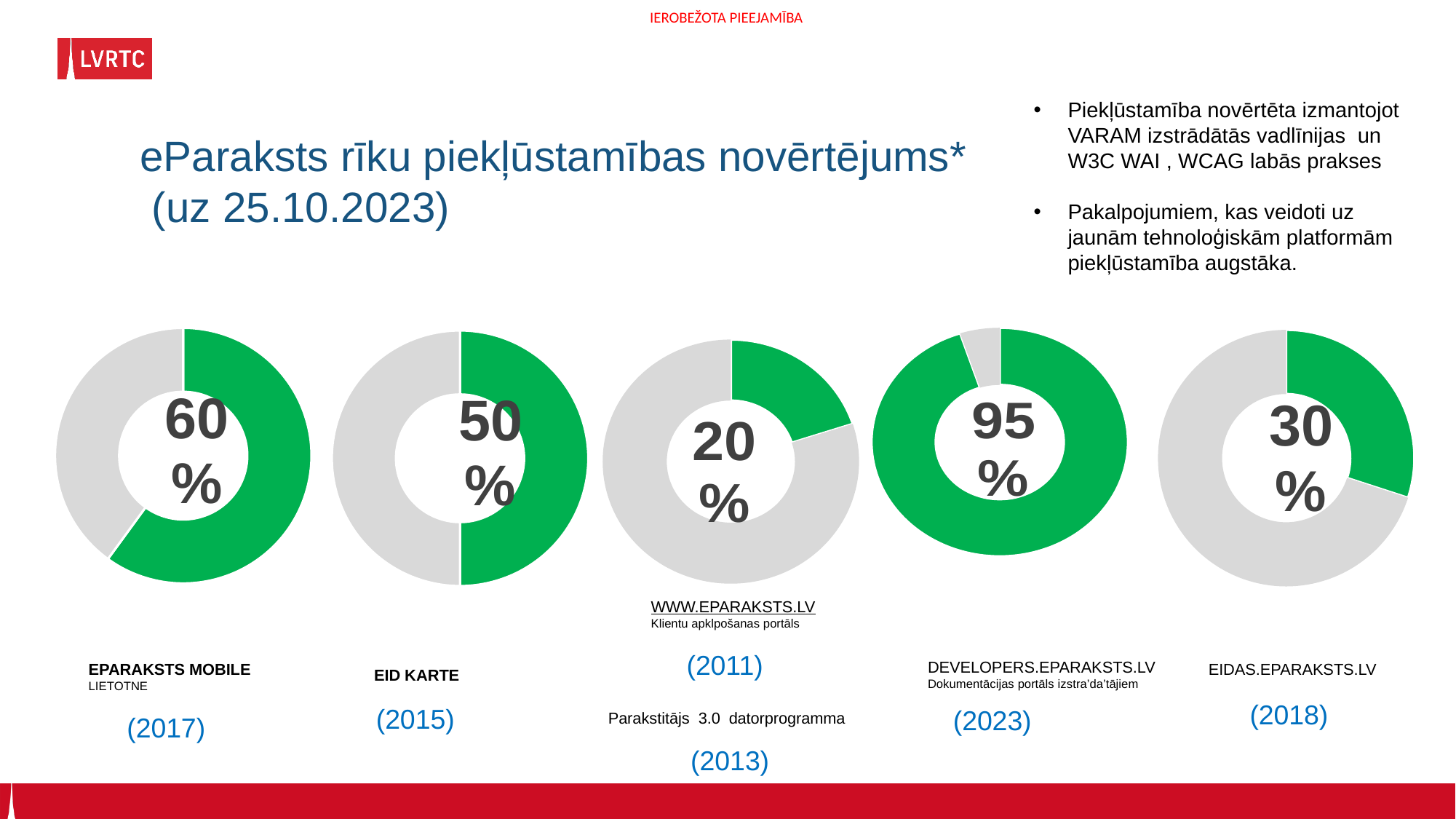
What colour is used for the filled (percentage) portion of each donut chart? Green What percentage is shown in the EPARAKSTS MOBILE donut chart? 60% How many donut charts are shown on the slide? 5 What percentage is shown in the DEVELOPERS.EPARAKSTS.LV donut chart? 95% What percentage is shown in the EIDAS.EPARAKSTS.LV donut chart? 30% What is the difference between the DEVELOPERS.EPARAKSTS.LV percentage and the EIDAS.EPARAKSTS.LV percentage? 65% Which donut chart shows the highest percentage? DEVELOPERS.EPARAKSTS.LV (95%) What kind of charts are shown on the slide? Donut (pie) charts Which donut chart shows the lowest percentage? The middle chart above WWW.EPARAKSTS.LV (20%) What percentage is shown in the middle donut chart (above WWW.EPARAKSTS.LV)? 20% What percentage is shown in the EID KARTE donut chart? 50% Which is larger, the EPARAKSTS MOBILE percentage or the EID KARTE percentage? EPARAKSTS MOBILE